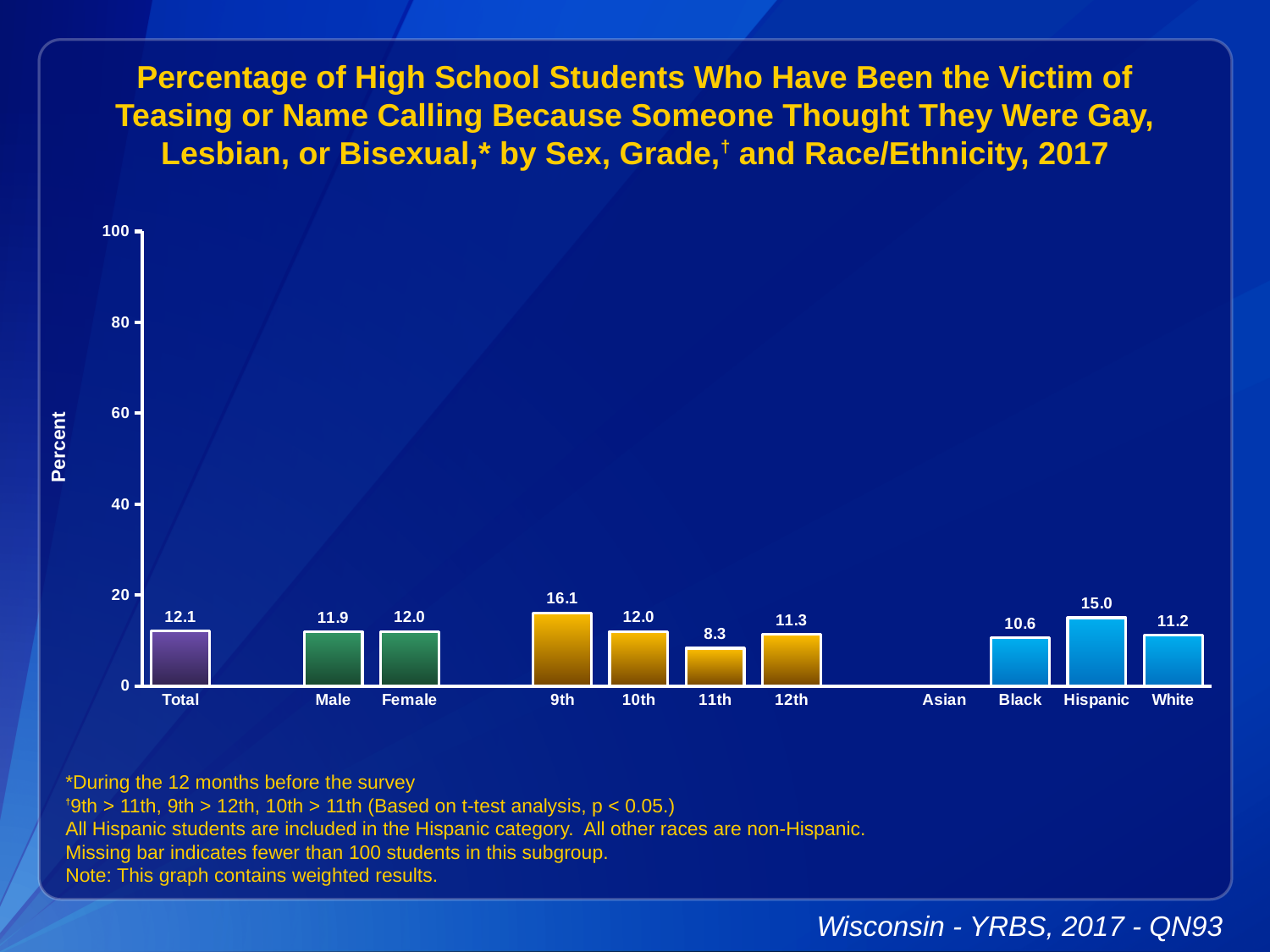
What is the value for Hispanic students? 15.0 What is the value for Total? 12.1 Is the value for Hispanic greater or less than 20? less Which category with a bar has the lowest value? 11th What is the value for 9th grade? 16.1 Which is larger, the value for Black or the value for White? White Which category has no bar shown? Asian Which category has the highest value? 9th What is the value for 11th grade? 8.3 How many categories are labeled on the x axis? 11 What is the difference between the values for 9th and 11th grade? 7.8 What kind of chart is this? bar chart